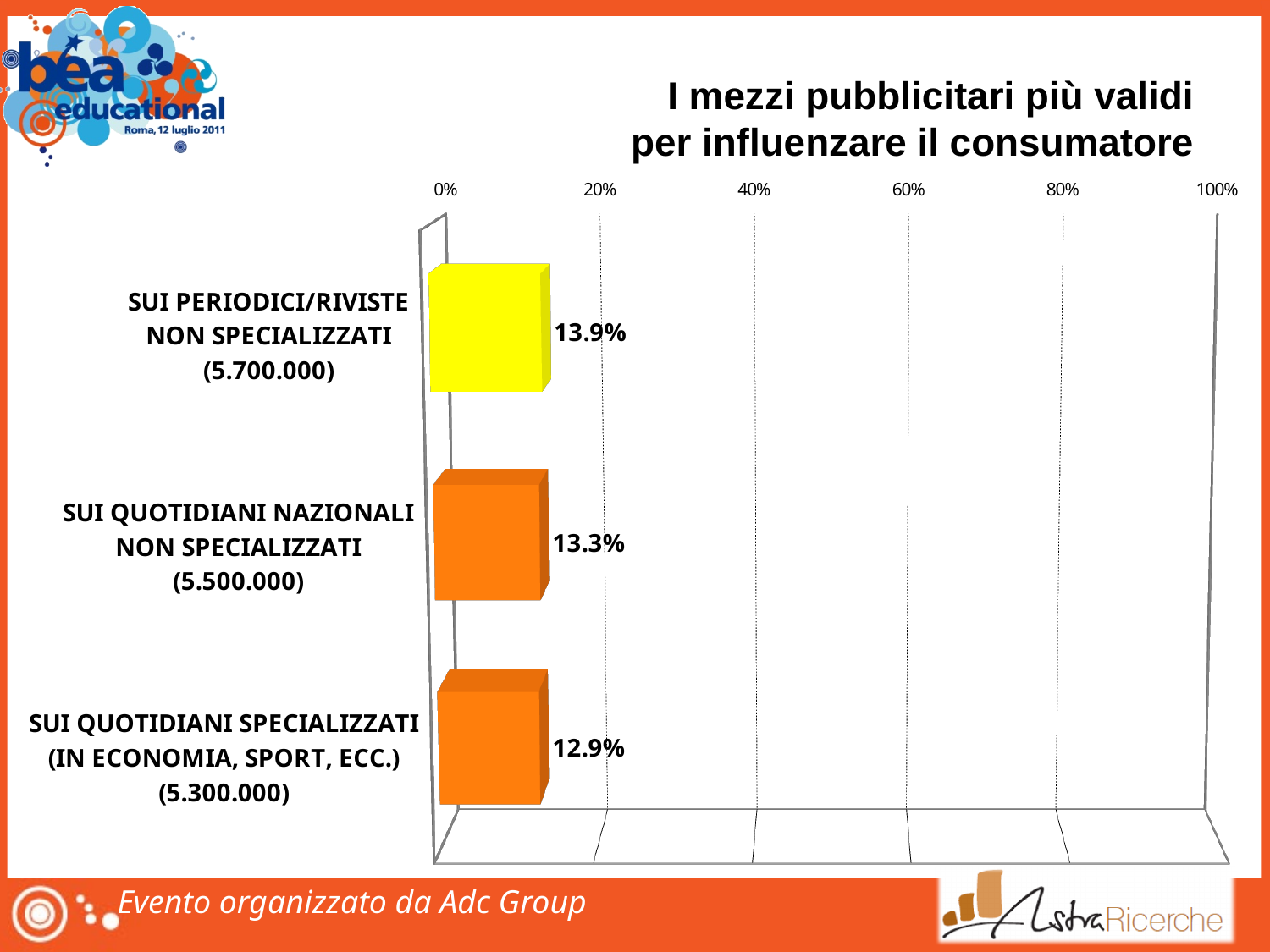
What is the title of the chart? I mezzi pubblicitari più validi per influenzare il consumatore What kind of chart is shown on the slide? bar chart What is the difference between the values for SUI PERIODICI/RIVISTE NON SPECIALIZZATI and SUI QUOTIDIANI SPECIALIZZATI (IN ECONOMIA, SPORT, ECC.)? 1.0% What is the difference between the values for SUI QUOTIDIANI NAZIONALI NON SPECIALIZZATI and SUI QUOTIDIANI SPECIALIZZATI (IN ECONOMIA, SPORT, ECC.)? 0.4% Is the value for SUI PERIODICI/RIVISTE NON SPECIALIZZATI greater or less than 20%? less How many categories are shown in the chart? 3 Which is larger, the value for SUI PERIODICI/RIVISTE NON SPECIALIZZATI or for SUI QUOTIDIANI NAZIONALI NON SPECIALIZZATI? SUI PERIODICI/RIVISTE NON SPECIALIZZATI Which category has the highest value? SUI PERIODICI/RIVISTE NON SPECIALIZZATI What is the value for SUI QUOTIDIANI SPECIALIZZATI (IN ECONOMIA, SPORT, ECC.)? 12.9% What is the value for SUI PERIODICI/RIVISTE NON SPECIALIZZATI? 13.9% What is the value for SUI QUOTIDIANI NAZIONALI NON SPECIALIZZATI? 13.3% Which category has the lowest value? SUI QUOTIDIANI SPECIALIZZATI (IN ECONOMIA, SPORT, ECC.)